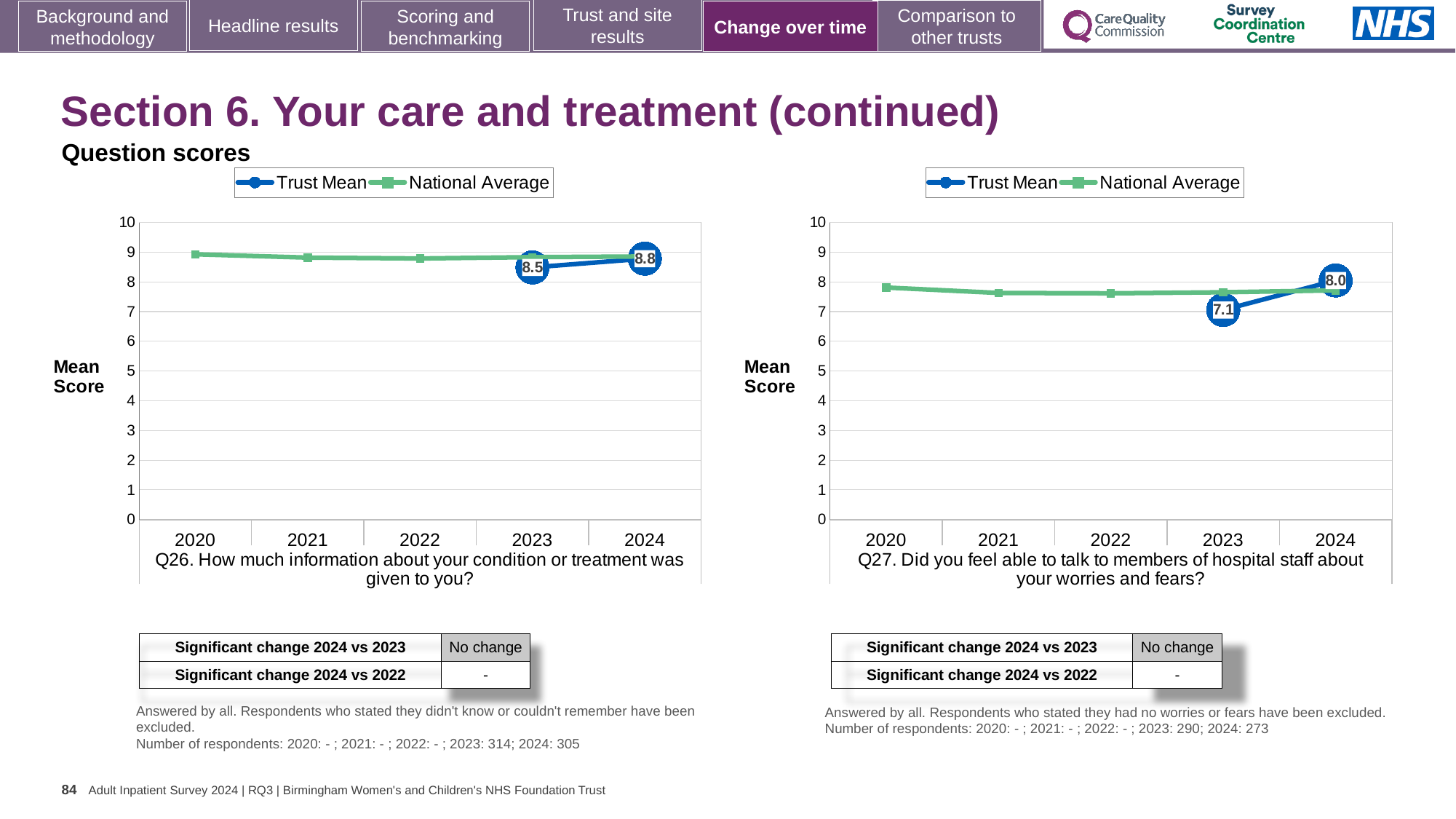
How many series does the legend of the Q26 chart list? 2 In the Q26 chart, what is the Trust Mean for 2024? 8.8 In the Q27 chart, what is the Trust Mean for 2024? 8.0 In the Q27 chart, what is the Trust Mean for 2023? 7.1 In the Q26 chart, is the National Average for 2021 greater or less than 8? greater In the Q27 chart, is the Trust Mean for 2023 higher or lower than the Trust Mean for 2024? lower In the Q27 chart, is the National Average for 2020 greater or less than 7? greater In the Q27 chart, by how much did the Trust Mean change from 2023 to 2024? 0.9 What type of chart is used for Q26? line chart How many years are shown on the x axis of the Q27 chart? 5 In the Q26 chart, what is the Trust Mean for 2023? 8.5 In the Q26 chart, what is the difference between the Trust Mean in 2024 and in 2023? 0.3